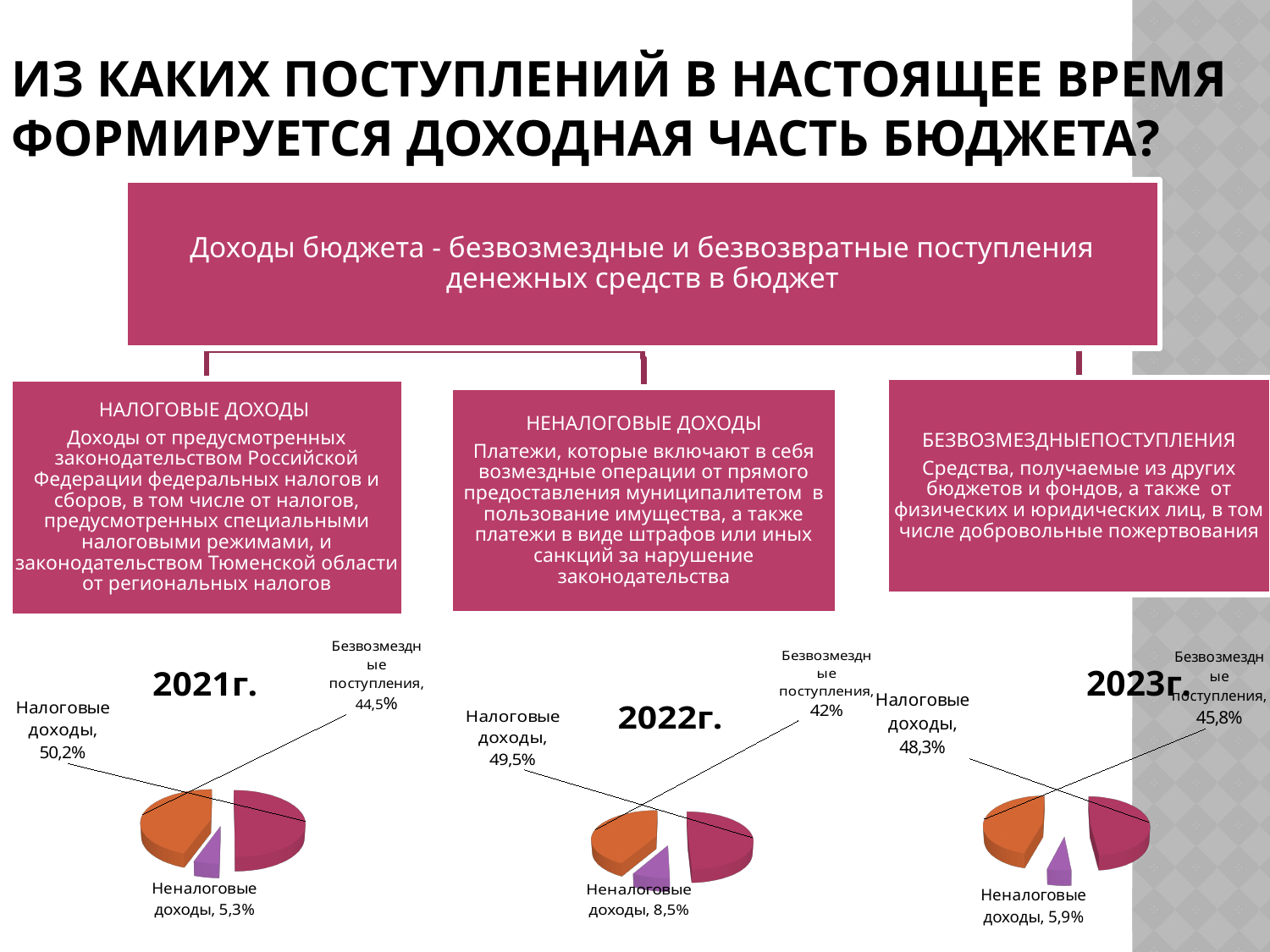
On the 2023г. pie chart, what is the difference between the shares of Налоговые доходы and Неналоговые доходы? 42,4% On the 2023г. pie chart, what share is shown for Безвозмездные поступления? 45,8% On the 2021г. pie chart, which is larger: Налоговые доходы or Безвозмездные поступления? Налоговые доходы On the 2021г. pie chart, what share is shown for Налоговые доходы? 50,2% How many pie charts are shown on the slide? 3 On the 2021г. pie chart, which category has the smallest share? Неналоговые доходы On the 2022г. pie chart, what is the difference between the shares of Налоговые доходы and Безвозмездные поступления? 7,5% On the 2023г. pie chart, which category has the largest share? Налоговые доходы On the 2022г. pie chart, what share is shown for Неналоговые доходы? 8,5% On the 2022г. pie chart, what share is shown for Безвозмездные поступления? 42% How many slices does the 2023г. pie chart have? 3 What type of chart is used to show the 2022г. data? Pie chart